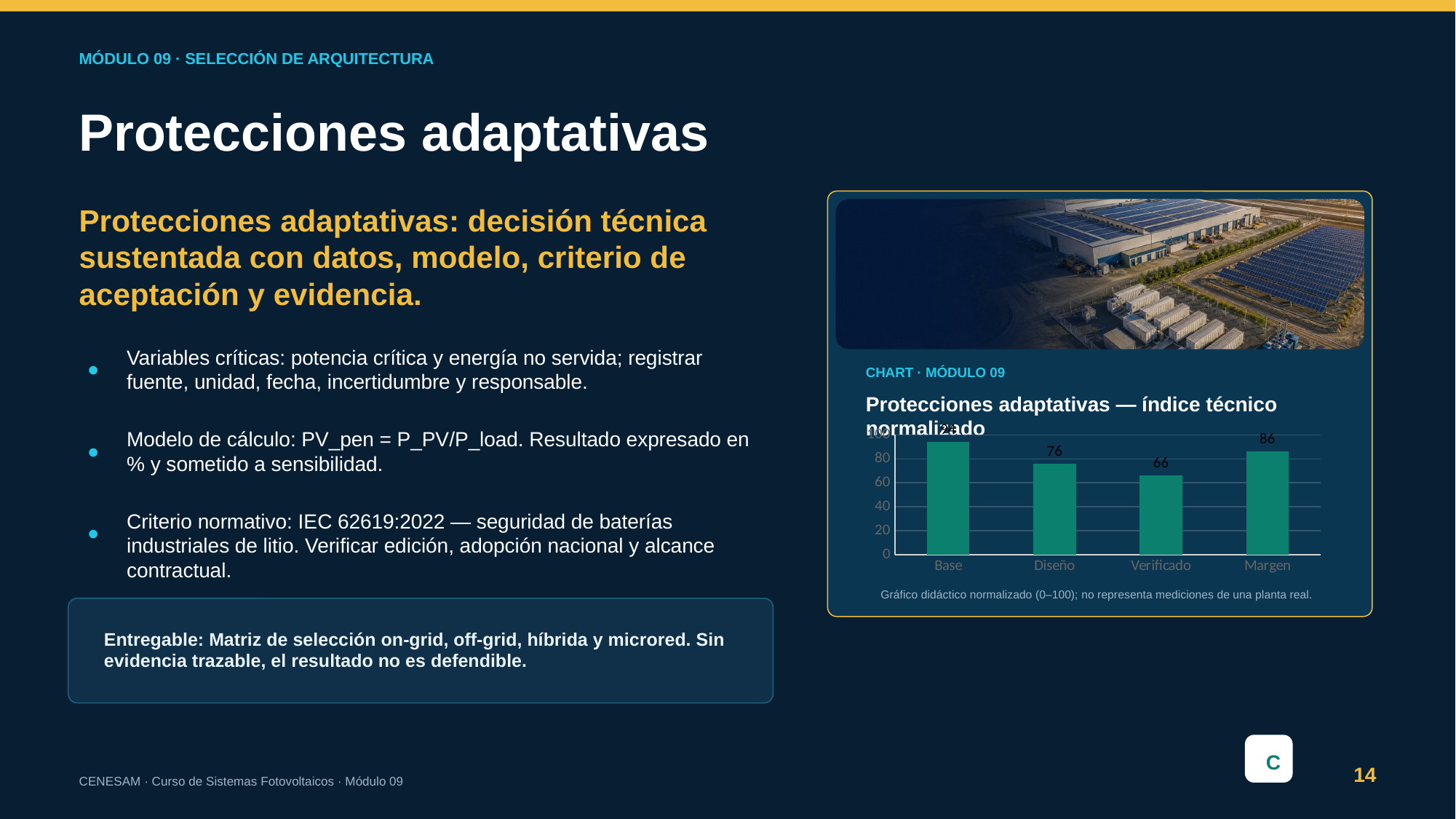
What is the value for Margen? 86 Which category has the lowest value? Verificado What is the difference between the values for Margen and Diseño? 10 How many categories are shown on the x axis? 4 Which category has the highest value? Base What is the value for Verificado? 66 Which is larger, the value for Diseño or the value for Verificado? Diseño What is the title of the chart? Protecciones adaptativas — índice técnico normalizado What is the difference between the values for Margen and Verificado? 20 What is the value for Diseño? 76 What type of chart is shown on the slide? Bar chart Is the value for Base greater or less than 80? greater